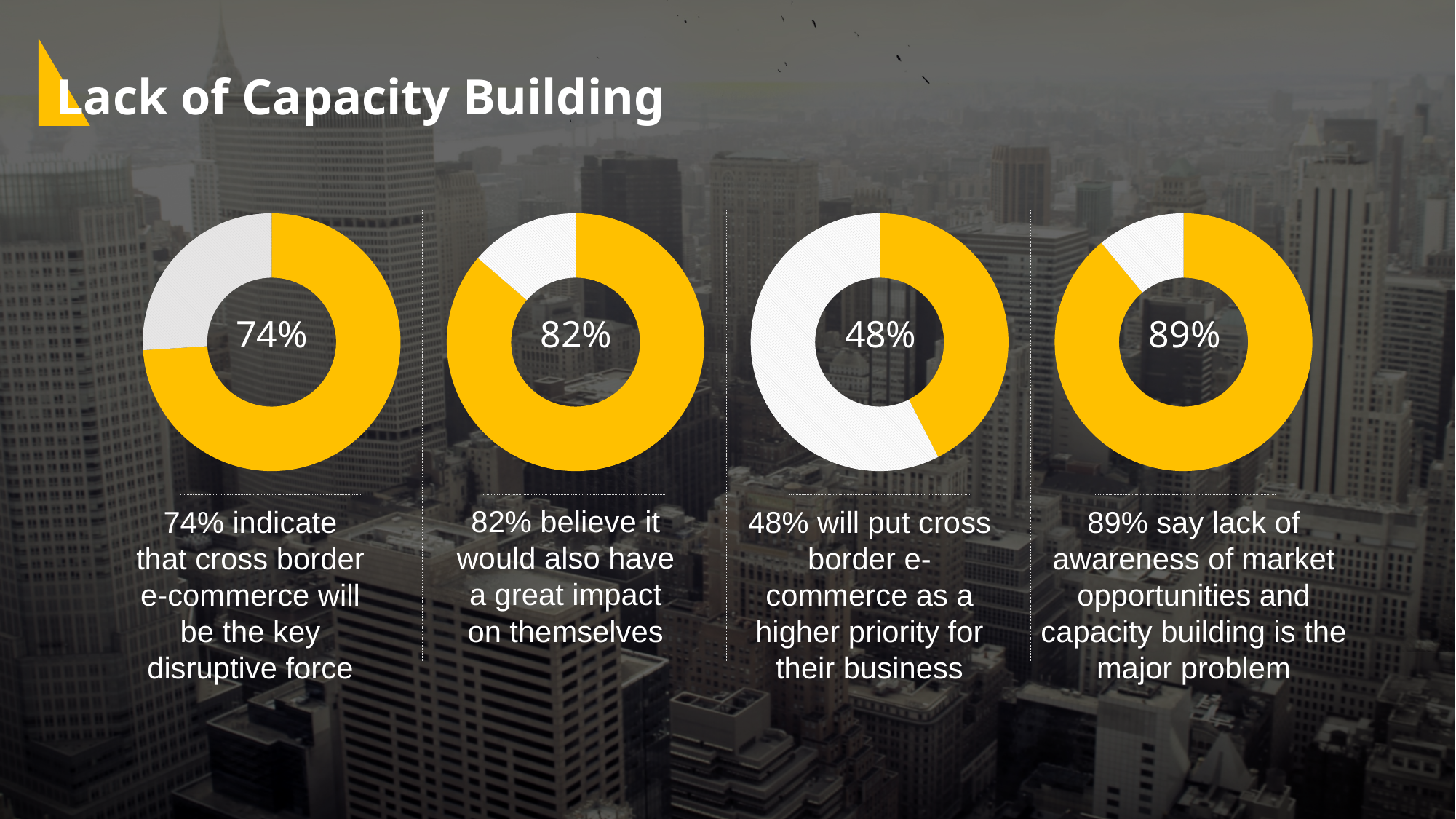
What is the difference between the percentage in the rightmost donut chart and the percentage in the leftmost donut chart? 15 percentage points How many donut charts are shown on the slide? 4 Which of the four donut charts shows the lowest percentage? The third chart from the left, 48% In the rightmost donut chart, what percentage is shown? 89% In the leftmost donut chart, what percentage is shown in the centre? 74% Which of the four donut charts shows the highest percentage? The rightmost chart, 89% What percentage of respondents say lack of awareness of market opportunities and capacity building is the major problem? 89% In the third donut chart from the left, what percentage is shown? 48% In the second donut chart from the left, what percentage is shown? 82% Which is larger: the percentage who believe cross border e-commerce would have a great impact on themselves, or the percentage who indicate it will be the key disruptive force? 82% (great impact on themselves) What kind of chart is used to display the percentages on this slide? Donut (pie) chart What colour is used for the highlighted (filled) portion of each donut chart? Yellow